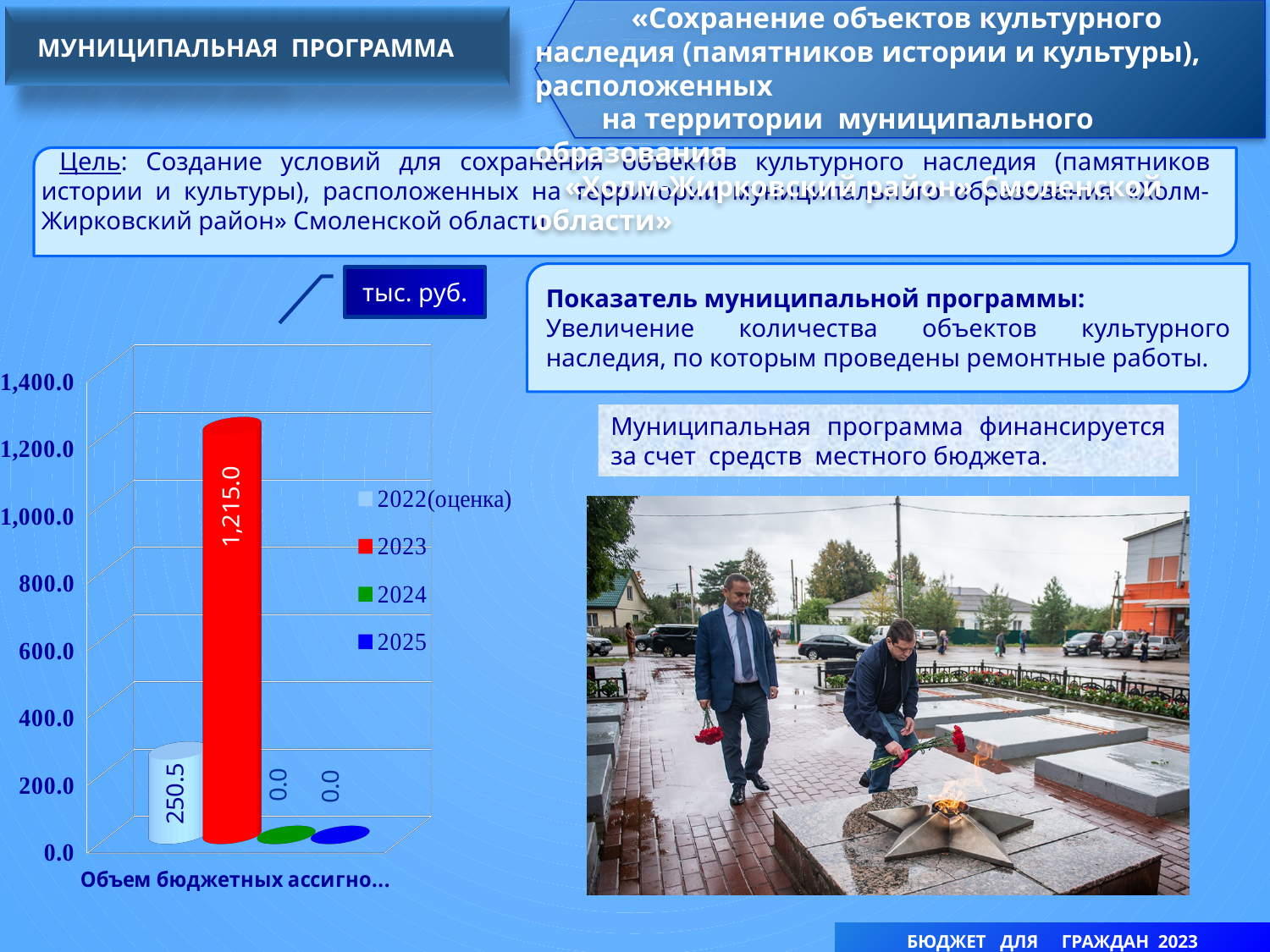
What is the value for 2022(оценка) in the chart? 250.5 How many series does the chart legend list? 4 What is the difference between the values for 2023 and 2022(оценка)? 964.5 Is the value for 2023 greater or less than 1,000.0? greater What is the value for 2024 in the chart? 0.0 Is the value for 2022(оценка) greater or less than 400.0? less What is the value for 2023 in the chart? 1,215.0 What kind of chart is shown on the slide? bar chart Which is larger, the value for 2022(оценка) or the value for 2023? 2023 Which year has the highest value in the chart? 2023 What is the value for 2025 in the chart? 0.0 What unit is shown in the label above the chart? тыс. руб.